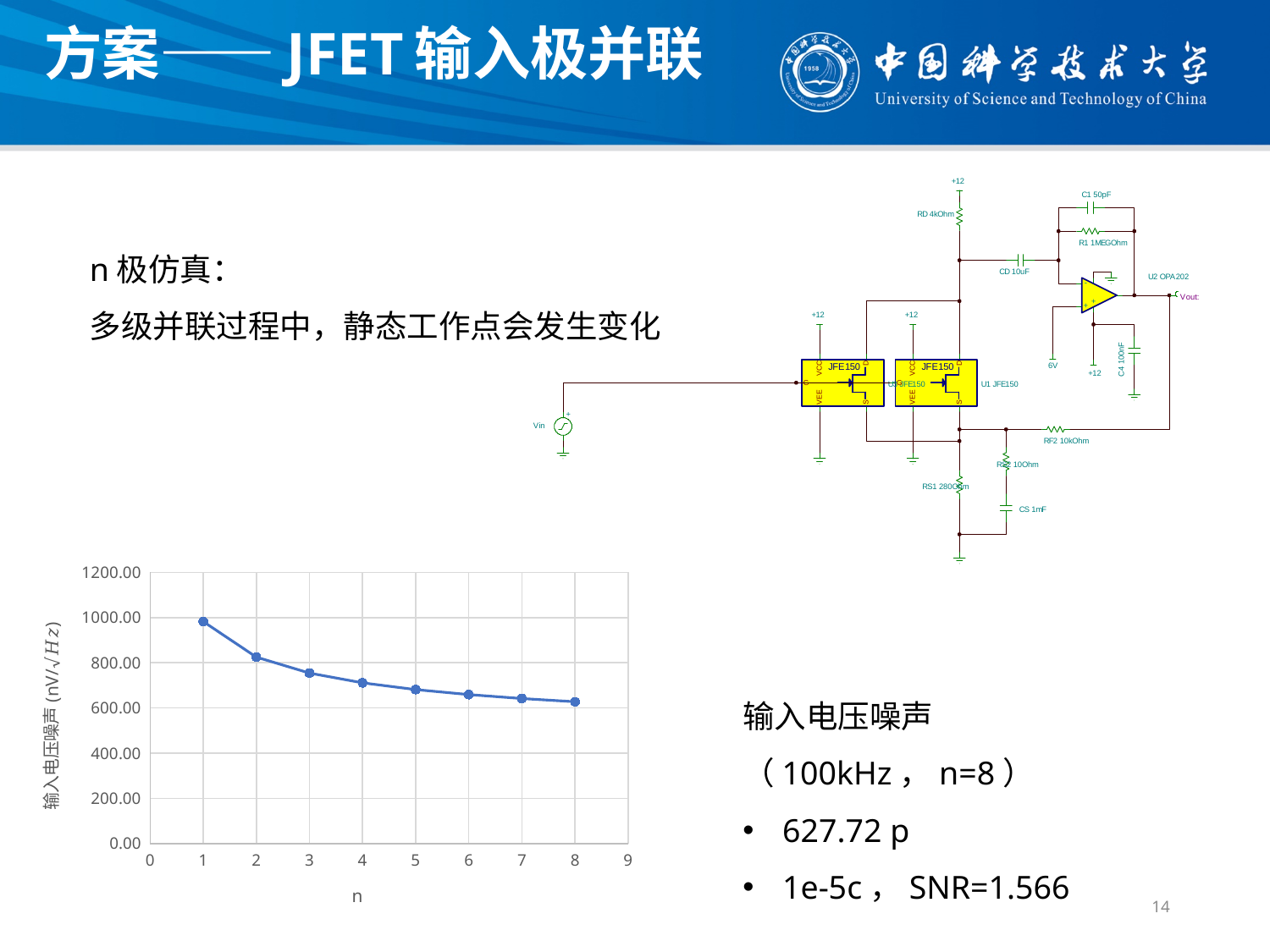
Do the values on the line chart rise or fall as n increases? fall What is the label of the x axis of the chart? n Is the value for n=1 greater or less than 800? greater Is the value for n=8 greater or less than 600? greater Which has a larger value on the chart, n=1 or n=8? n=1 At which value of n is the input voltage noise lowest? 8 What kind of chart is shown on the slide? line chart Is the value for n=3 greater or less than 800? less How many data points are plotted on the line chart? 8 At which value of n is the input voltage noise highest? 1 What is the highest tick value shown on the y axis of the chart? 1200.00